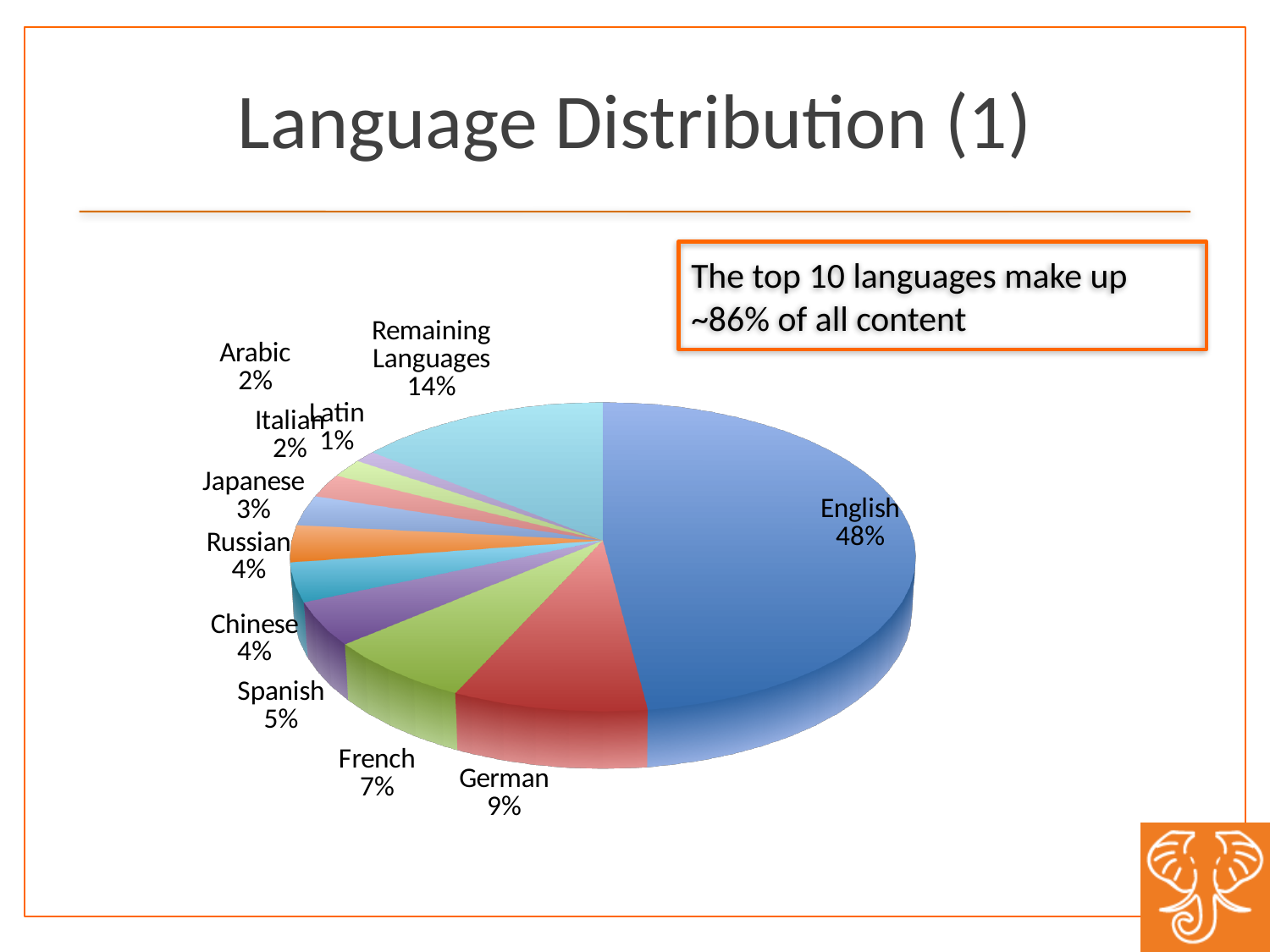
What is the title of the slide containing the pie chart? Language Distribution (1) Which language has the smallest slice of the pie? Latin What is the value shown for German? 9% What is the difference between the shares for French and Spanish? 2% Which slice of the pie is the largest? English What is the difference between the shares for English and German? 39% How many slices does the pie chart have? 11 What is the value shown for Remaining Languages? 14% What kind of chart is shown on the slide? pie chart Which is larger, the share for French or the share for Chinese? French What is the value shown for Japanese? 3% What share of the pie does English account for? 48%